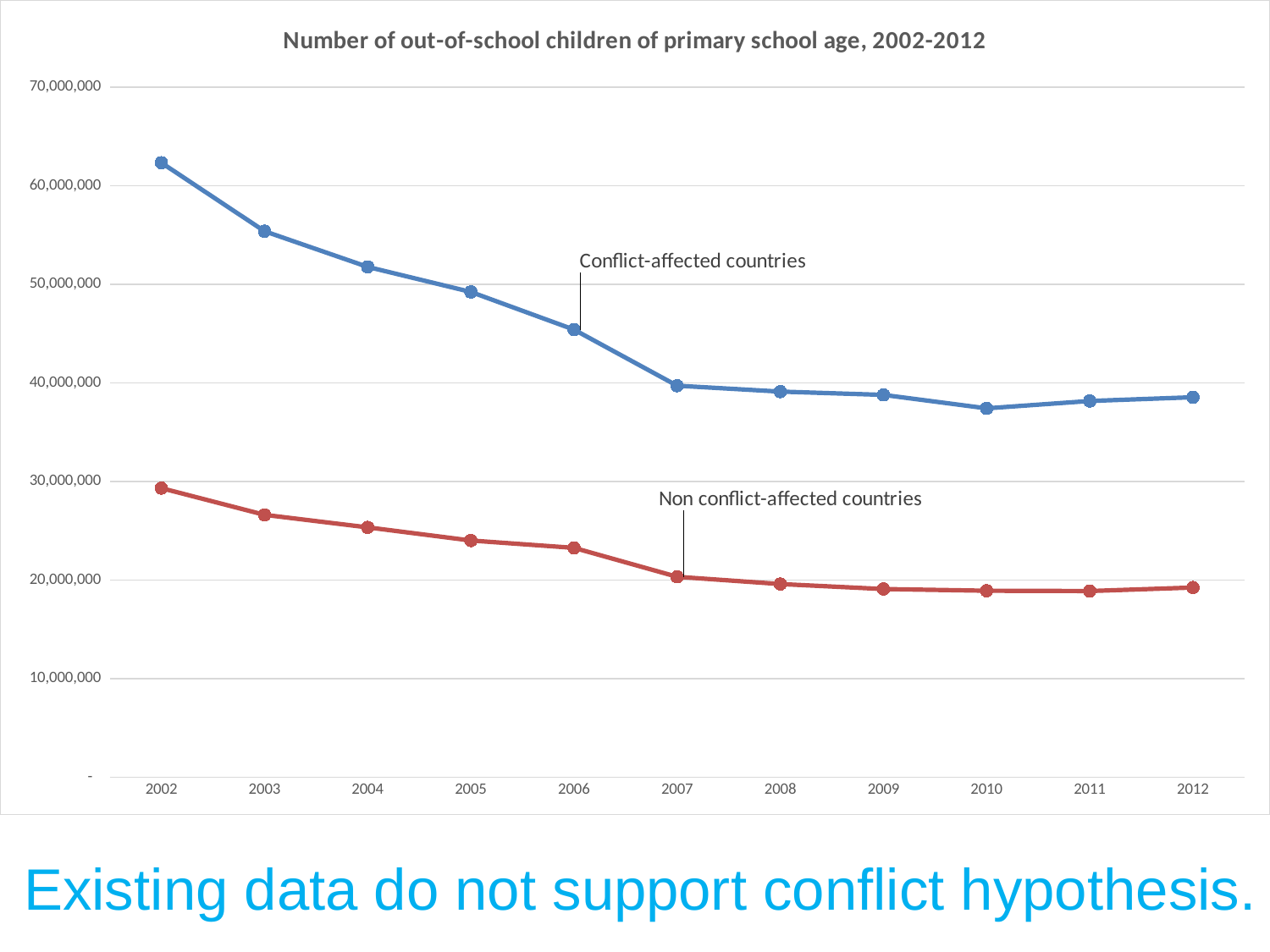
Is the value for Non conflict-affected countries in 2010 greater or less than 20,000,000? less In which year is the value for Non conflict-affected countries highest? 2002 In which year is the value for Conflict-affected countries lowest? 2010 How many years are shown on the x axis of the chart? 11 In which year is the value for Conflict-affected countries highest? 2002 Does the value for Conflict-affected countries rise or fall from 2002 to 2007? Fall What kind of chart is shown on the slide? Line chart Is the value for Conflict-affected countries in 2006 greater or less than 40,000,000? greater Is the value for Non conflict-affected countries in 2003 greater or less than 30,000,000? less How many series are plotted on the chart? 2 Which series has the larger value in 2012, Conflict-affected countries or Non conflict-affected countries? Conflict-affected countries